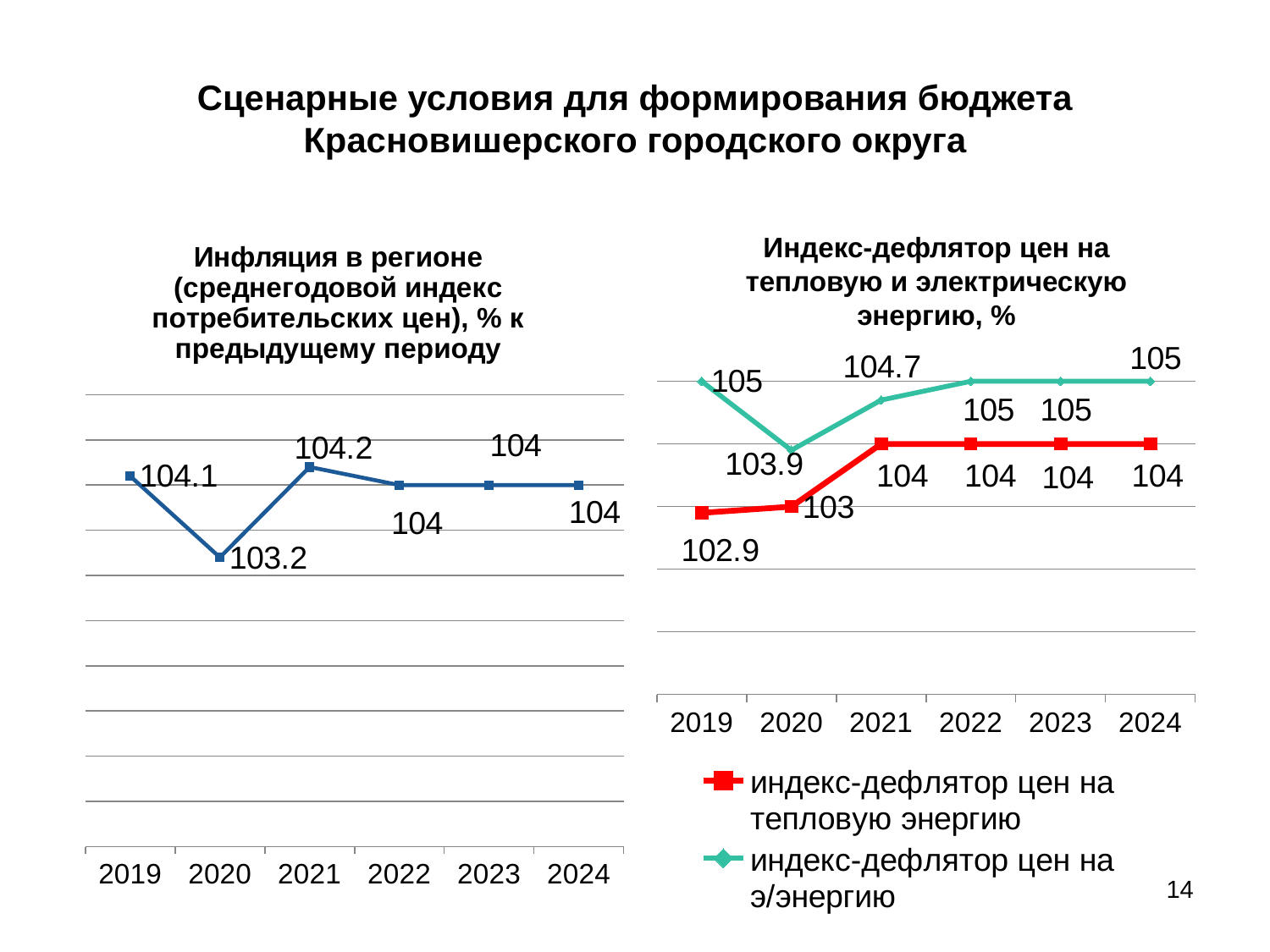
In the right chart (Индекс-дефлятор цен), what is the value for индекс-дефлятор цен на тепловую энергию in 2019? 102.9 In the right chart (Индекс-дефлятор цен), what is the difference between the э/энергию value and the тепловую энергию value in 2024? 1 In the right chart (Индекс-дефлятор цен), how many series does the legend list? 2 In the left chart (Инфляция в регионе), what is the difference between the 2021 value and the 2020 value? 1 In the right chart (Индекс-дефлятор цен), what is the value for индекс-дефлятор цен на э/энергию in 2021? 104.7 In the right chart (Индекс-дефлятор цен), does the тепловую энергию series rise or fall from 2019 to 2021? rise In the left chart (Инфляция в регионе), how many years are plotted on the x axis? 6 What kind of chart is the left chart (Инфляция в регионе)? line chart In the left chart (Инфляция в регионе), what is the value for 2020? 103.2 In the left chart (Инфляция в регионе), which year has the highest value? 2021 In the left chart (Инфляция в регионе), which year has the lowest value? 2020 In the right chart (Индекс-дефлятор цен), which series has the larger value in 2020: тепловую энергию or э/энергию? э/энергию